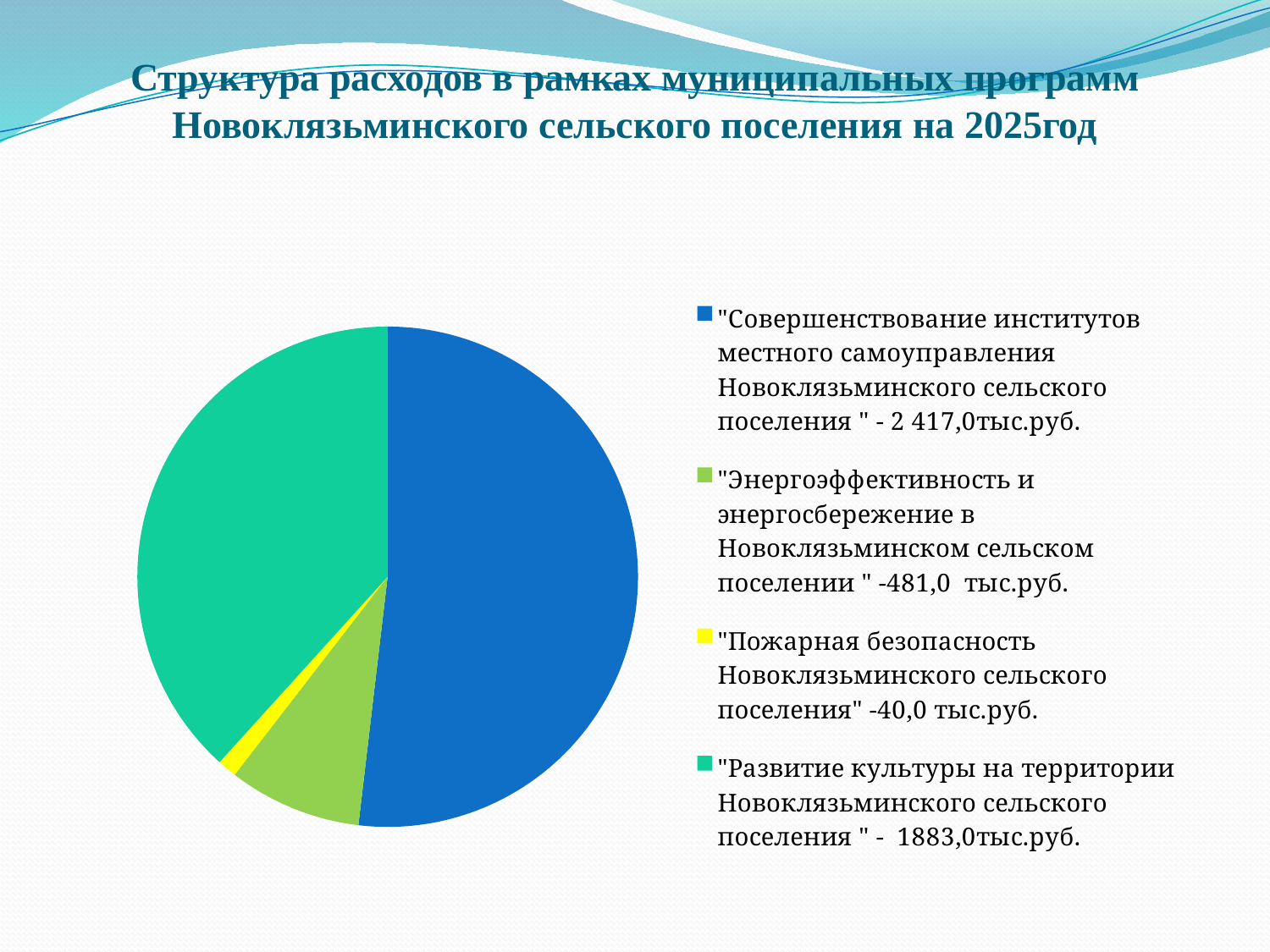
Which program has the largest share of the pie? "Совершенствование институтов местного самоуправления Новоклязьминского сельского поселения" What kind of chart is shown on the slide? pie chart How many entries does the legend of the pie chart list? 4 What is the value for "Энергоэффективность и энергосбережение в Новоклязьминском сельском поселении"? 481,0 тыс.руб. How many slices does the pie chart have? 4 Which program has the smallest share of the pie? "Пожарная безопасность Новоклязьминского сельского поселения" Which is larger: the value for "Энергоэффективность и энергосбережение" or the value for "Развитие культуры"? "Развитие культуры" What is the value for "Развитие культуры на территории Новоклязьминского сельского поселения"? 1883,0 тыс.руб. What colour is the slice for "Пожарная безопасность Новоклязьминского сельского поселения"? yellow What is the difference between the value for "Совершенствование институтов местного самоуправления" and the value for "Развитие культуры"? 534,0 тыс.руб. What is the value for "Пожарная безопасность Новоклязьминского сельского поселения"? 40,0 тыс.руб. What is the value for "Совершенствование институтов местного самоуправления Новоклязьминского сельского поселения"? 2 417,0 тыс.руб.